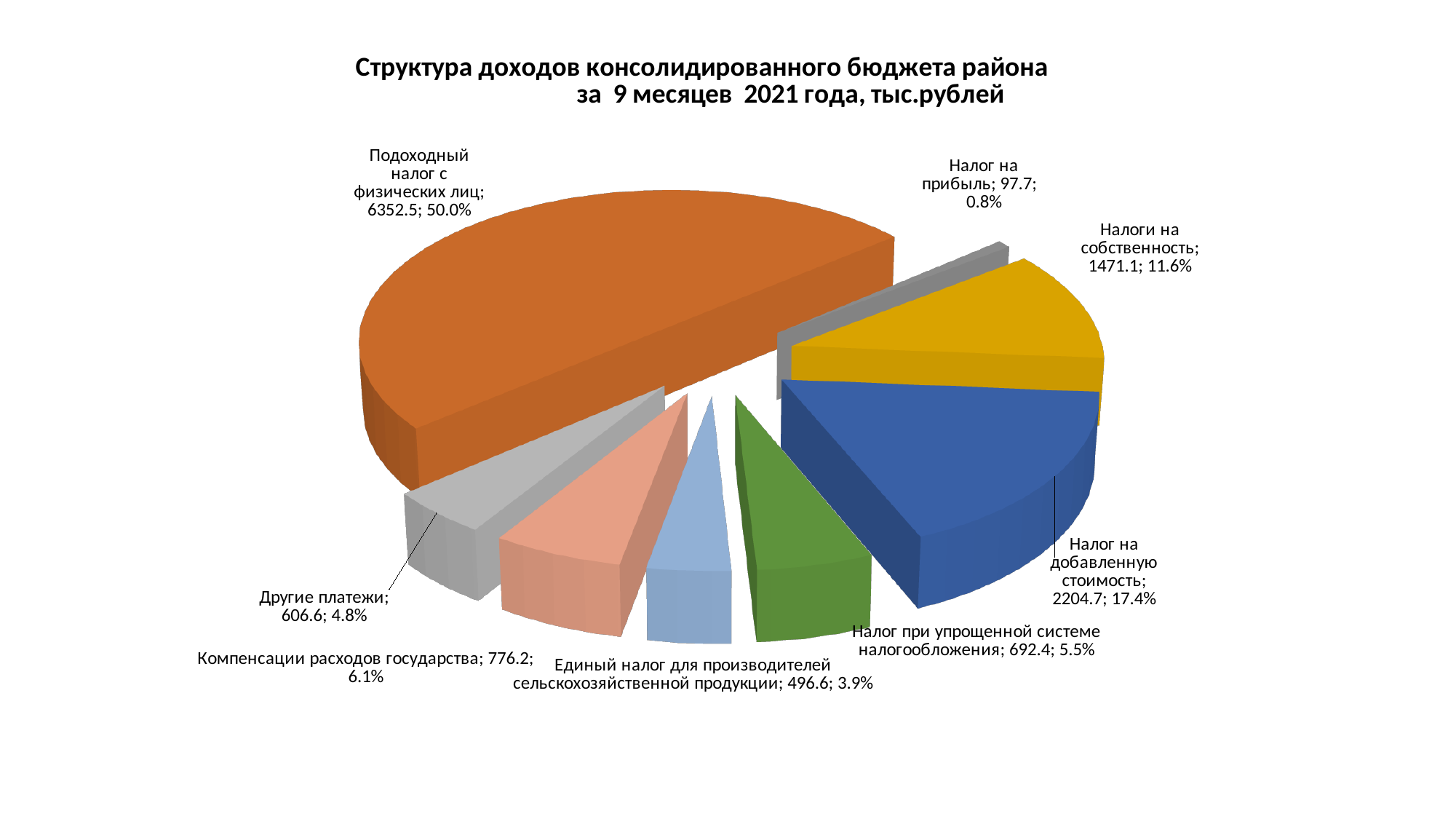
What share of the pie does Налог на добавленную стоимость represent? 17.4% Which category has the smallest slice? Налог на прибыль What is the difference between the values for Налог на добавленную стоимость and Налоги на собственность? 733.6 What is the value for Подоходный налог с физических лиц? 6352.5 How many slices does the pie chart have? 8 Which is larger: Компенсации расходов государства or Другие платежи? Компенсации расходов государства Which category has the largest slice? Подоходный налог с физических лиц What kind of chart is shown on the slide? Pie chart What is the value for Налоги на собственность? 1471.1 What share of the pie does Единый налог для производителей сельскохозяйственной продукции represent? 3.9% What is the value for Налог при упрощенной системе налогообложения? 692.4 What is the title of the chart? Структура доходов консолидированного бюджета района за 9 месяцев 2021 года, тыс.рублей